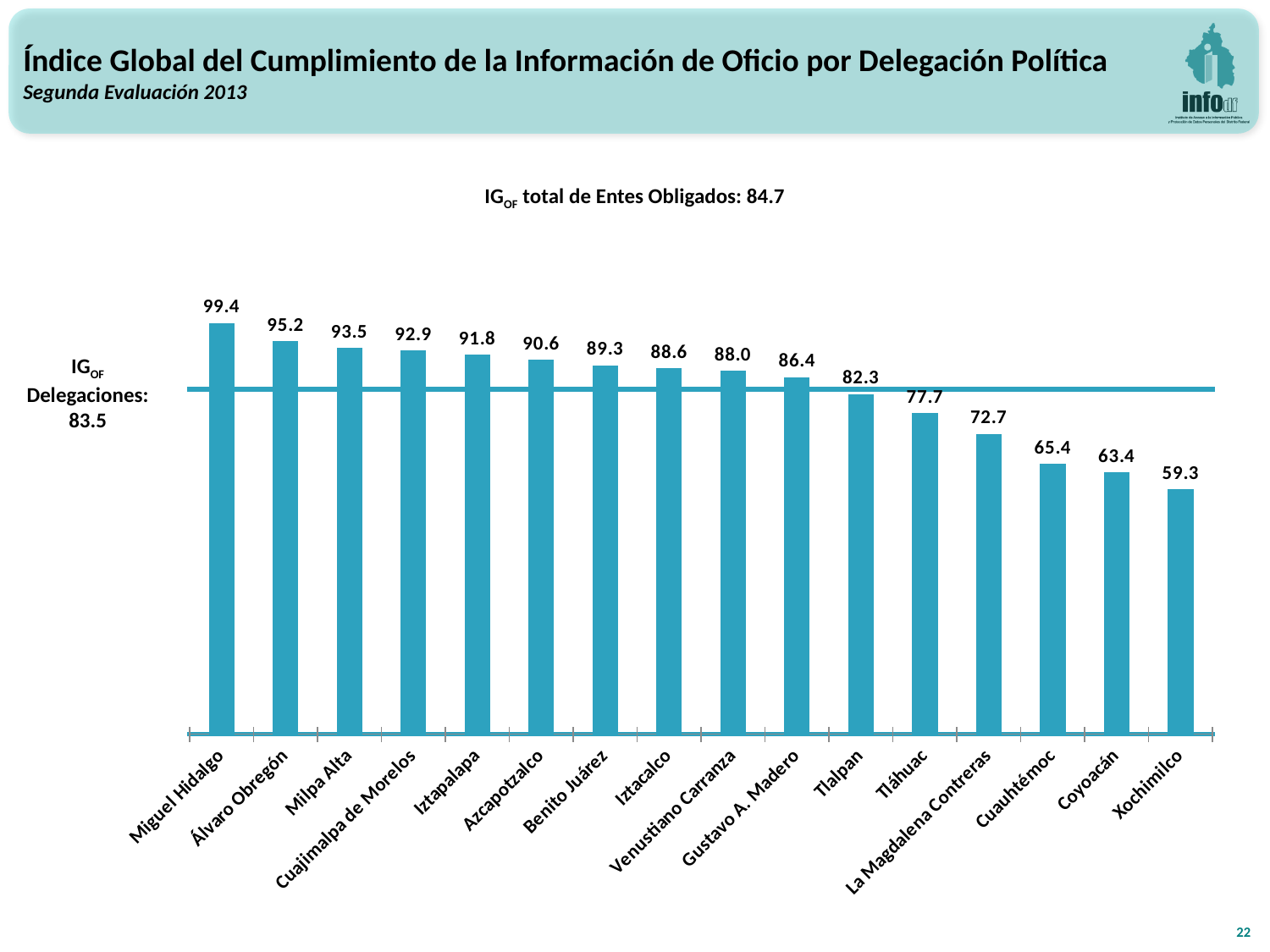
Which delegación has the highest value? Miguel Hidalgo What is the value for Miguel Hidalgo? 99.4 Which is larger, the value for Iztacalco or the value for Coyoacán? Iztacalco What is the value for Tlalpan? 82.3 What value does the horizontal reference line labelled IG OF Delegaciones represent? 83.5 Do the values rise or fall from left to right along the x axis? Fall What kind of chart is shown on the slide? Bar chart What is the value for La Magdalena Contreras? 72.7 What is the difference between the values for Miguel Hidalgo and Xochimilco? 40.1 Which delegación has the lowest value? Xochimilco What is the difference between the values for Tláhuac and Cuauhtémoc? 12.3 How many delegaciones are shown in the chart? 16